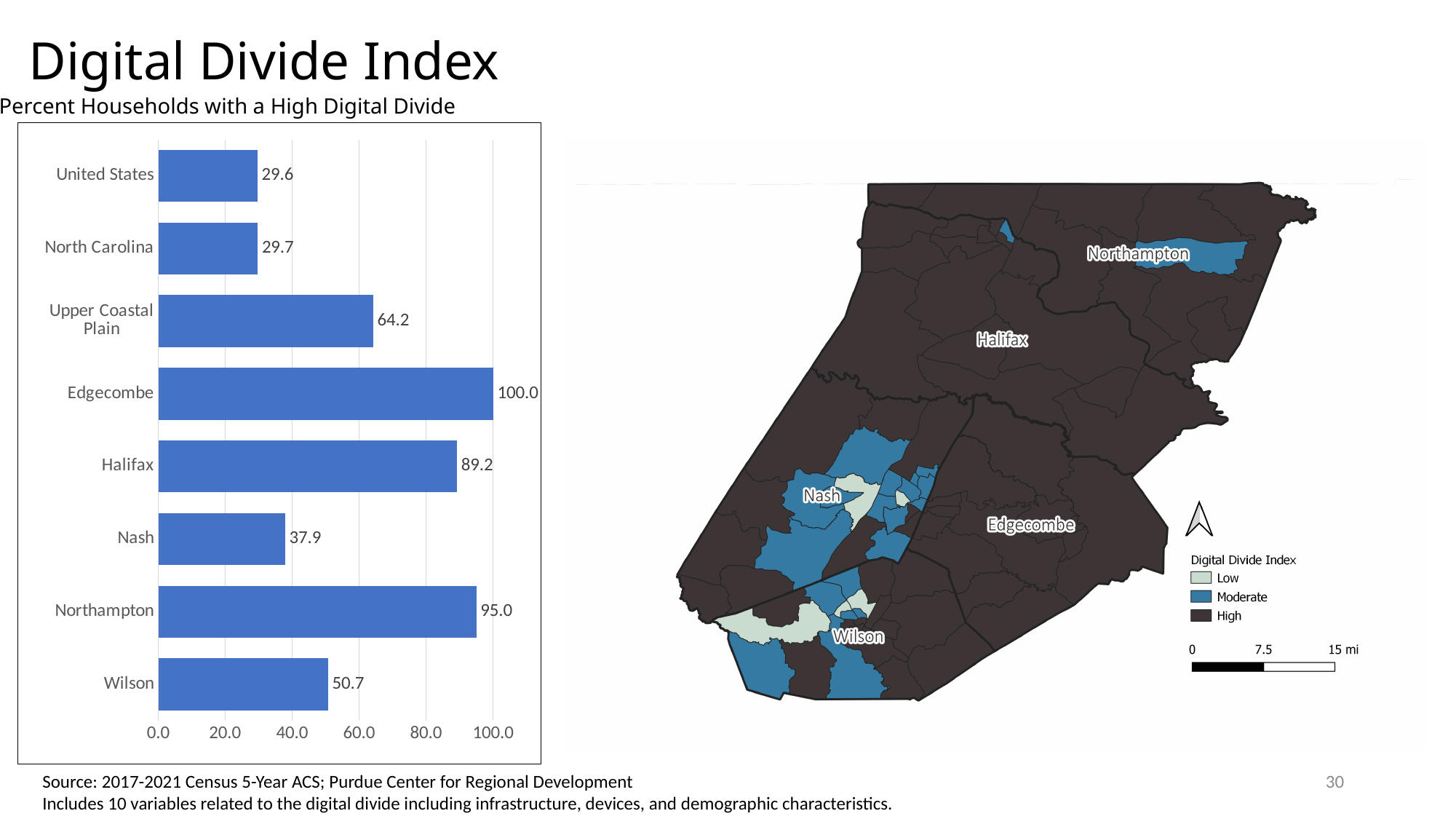
Is the value for Halifax in the bar chart greater or less than 80.0? greater How many categories are shown in the bar chart? 8 What is the value for Halifax in the bar chart? 89.2 What is the subtitle printed above the bar chart? Percent Households with a High Digital Divide Which is larger in the bar chart, the value for Wilson or the value for Nash? Wilson What is the value for Upper Coastal Plain in the bar chart? 64.2 What is the value for Edgecombe in the bar chart? 100.0 What kind of chart is shown on the left of the slide? bar chart Which category has the highest value in the bar chart? Edgecombe Which category has the lowest value in the bar chart? United States What is the value for Wilson in the bar chart? 50.7 What is the difference between the values for Northampton and Nash in the bar chart? 57.1